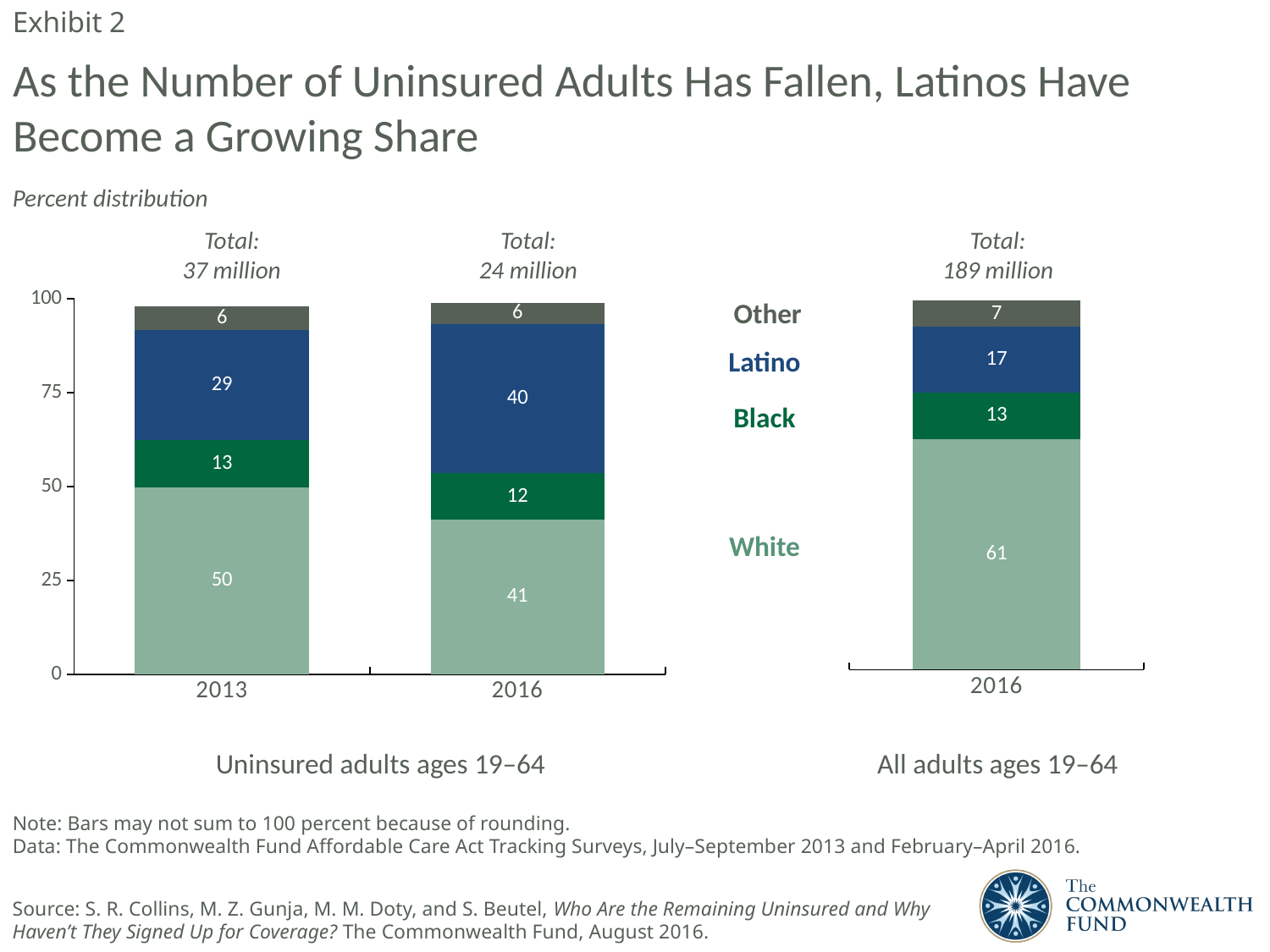
What is the total number of uninsured adults ages 19–64 shown for 2016? 24 million Which group has the smallest share of all adults ages 19–64 in 2016? Other What is the Black share of all adults ages 19–64 in 2016? 13 What is the White share of uninsured adults ages 19–64 in 2013? 50 What is the Other share of uninsured adults ages 19–64 in 2013? 6 What kind of chart is shown on the slide? Stacked bar chart Did the White share of uninsured adults rise or fall from 2013 to 2016? Fall By how many percentage points did the Latino share of uninsured adults change from 2013 to 2016? 11 How many groups does the legend list? 4 Is the Latino share larger among uninsured adults in 2016 or among all adults in 2016? Uninsured adults in 2016 What is the Latino share of uninsured adults ages 19–64 in 2016? 40 Which group has the largest share of uninsured adults ages 19–64 in 2016? White